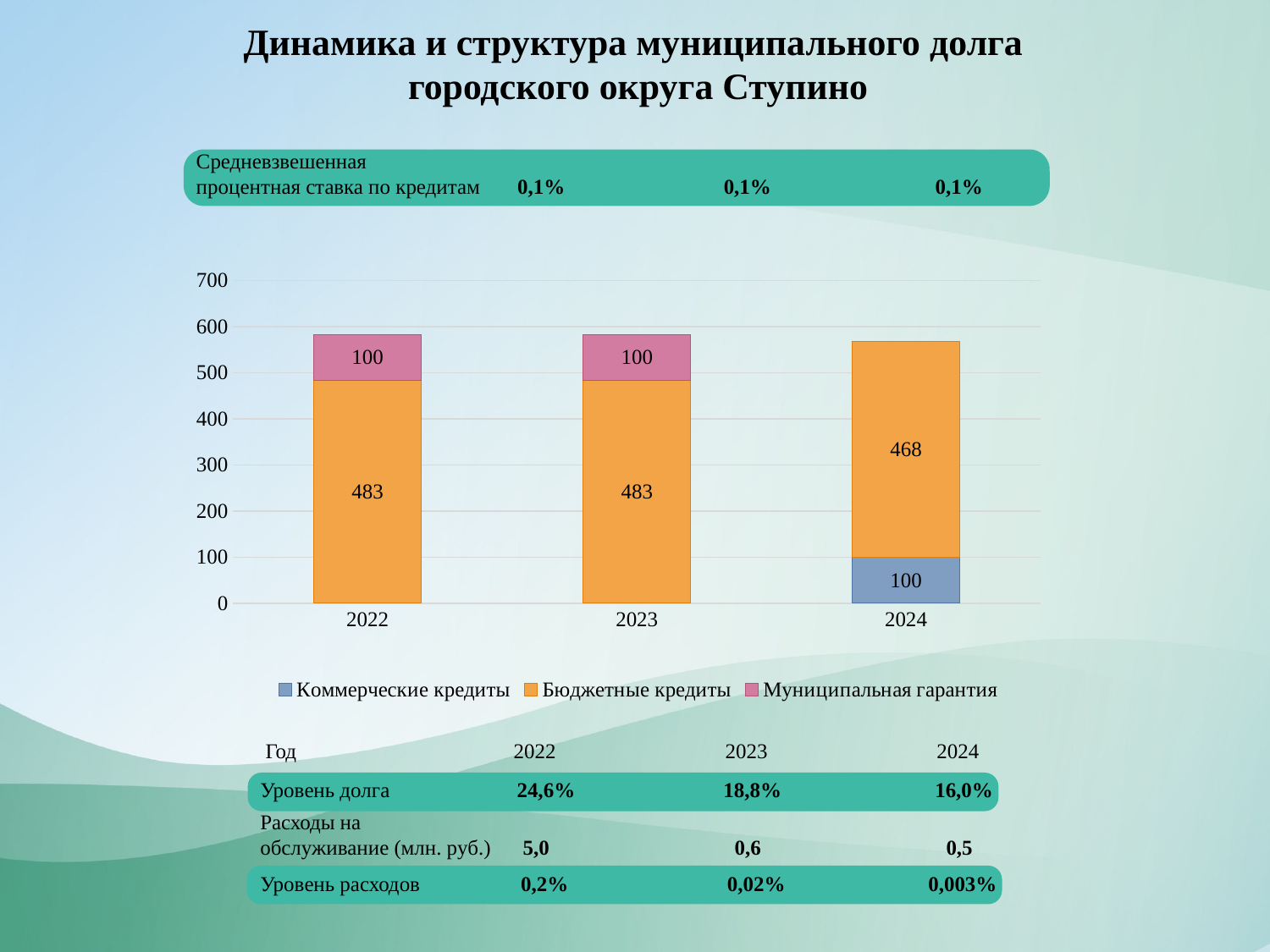
What is the value of Бюджетные кредиты for 2024? 468 Which year has the lowest value for Бюджетные кредиты? 2024 What is the value of Бюджетные кредиты for 2022? 483 What is the total of the stacked bar for 2022? 583 How many years are shown on the x axis of the chart? 3 What is the total of the stacked bar for 2024? 568 What is the value of Коммерческие кредиты for 2024? 100 How many series does the chart legend list? 3 What is the value of Муниципальная гарантия for 2023? 100 What type of chart is shown on the slide? Stacked bar chart Which series is shown in orange in the chart legend? Бюджетные кредиты What is the difference between Бюджетные кредиты in 2023 and in 2024? 15